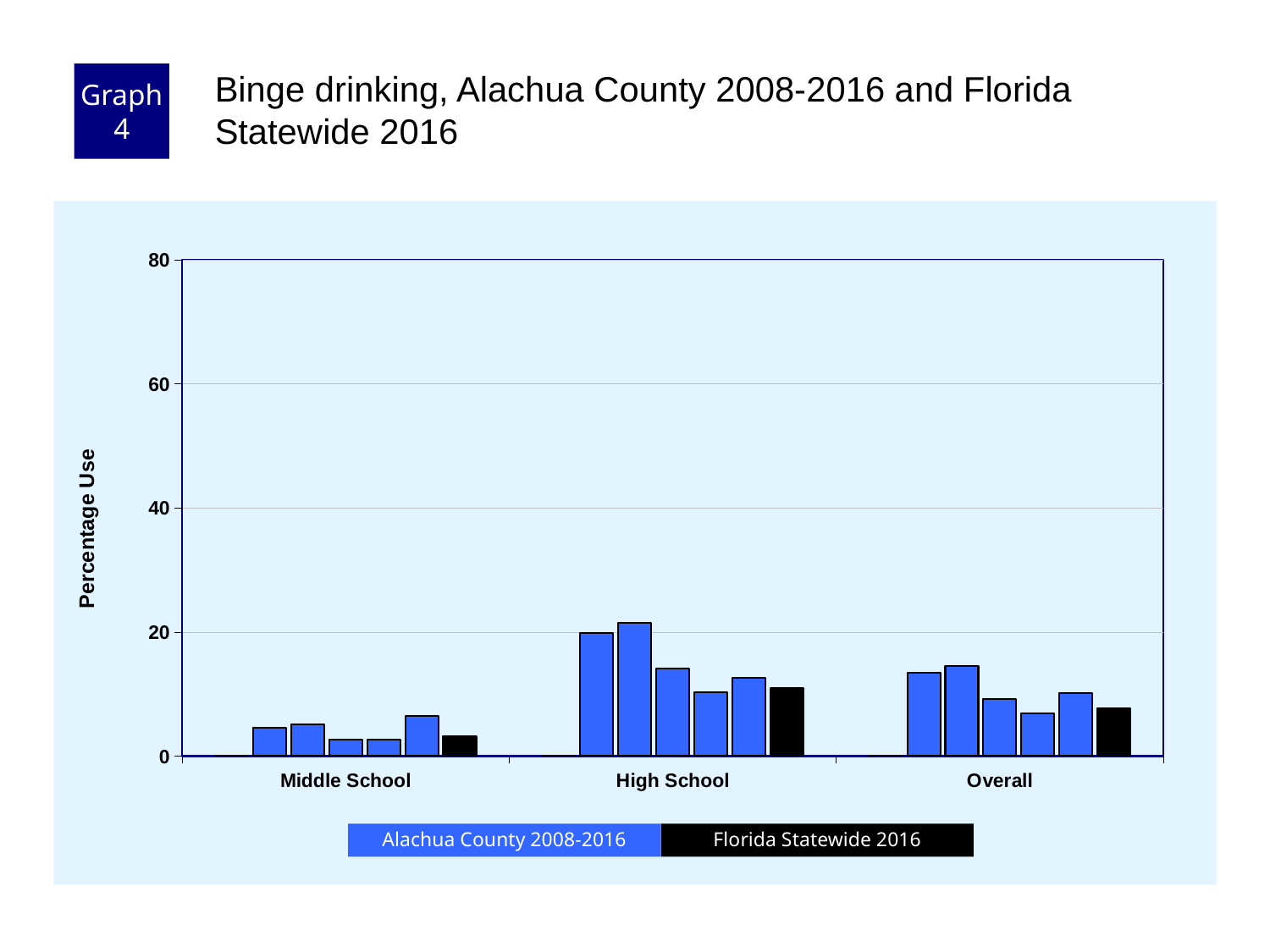
Is the Florida Statewide 2016 value for Middle School greater or less than 20? less Which category has the highest Florida Statewide 2016 value? High School What kind of chart is shown on the slide? bar chart What is the label on the y axis? Percentage Use Are any of the Middle School bars greater than 20? no Which series is shown in black in the legend? Florida Statewide 2016 Is the Florida Statewide 2016 value for Overall greater or less than 20? less How many series does the legend list? 2 Which category has the lowest Florida Statewide 2016 value? Middle School Which is larger, the Florida Statewide 2016 value for High School or for Middle School? High School How many categories are shown on the x axis? 3